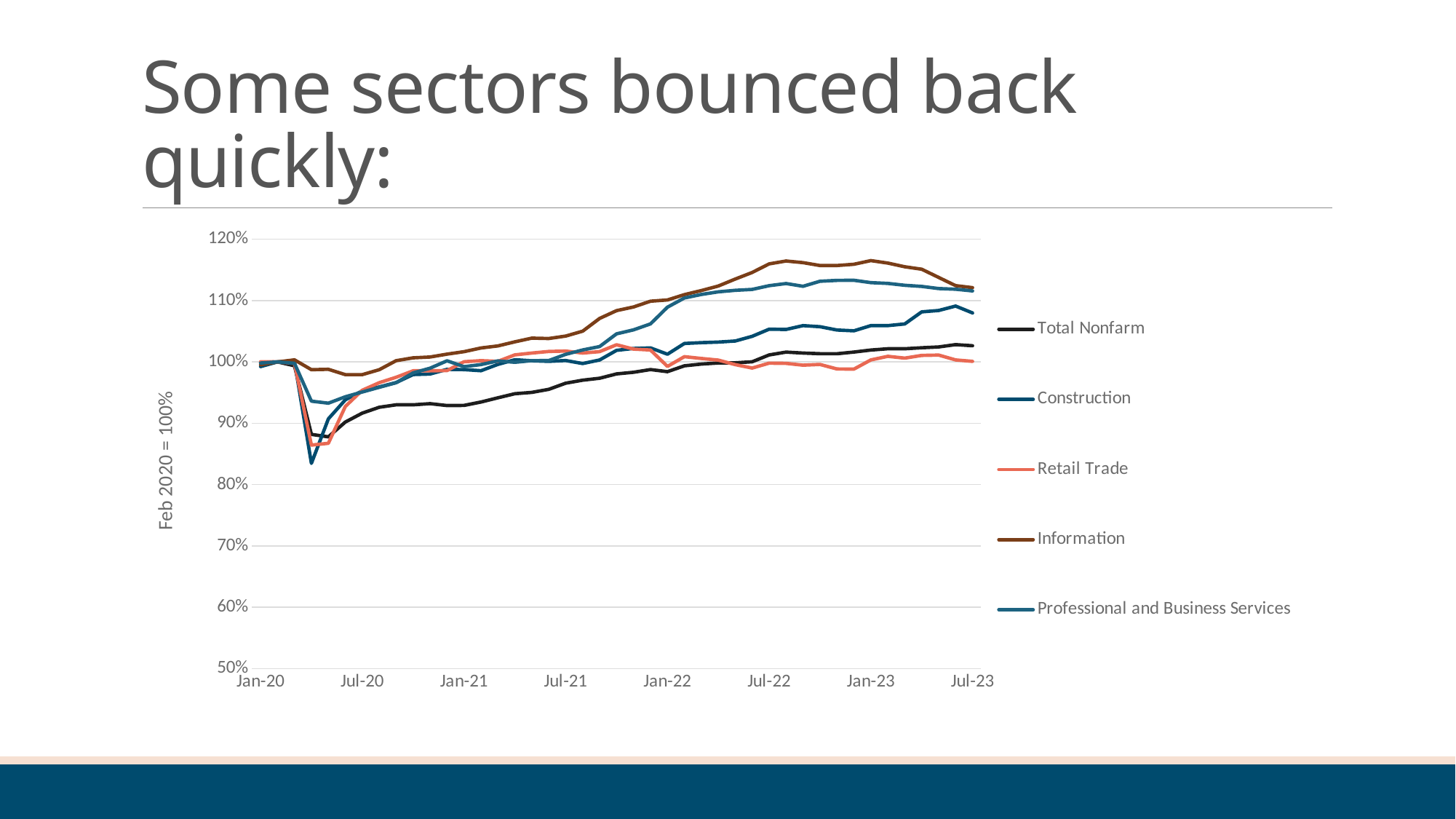
What is the title of the slide above the chart? Some sectors bounced back quickly: What kind of chart is shown on the slide? line chart Is the value for Construction at Jul-23 greater or less than 100%? greater What is the label on the vertical axis of the chart? Feb 2020 = 100% Which series dropped to the lowest point during 2020? Construction Which series is highest at Jul-22? Information How many series does the legend list? 5 At Jan-23, which is larger: Information or Retail Trade? Information Is the value for Total Nonfarm at Jul-20 greater or less than 100%? less Which series is lowest at Jul-23? Retail Trade Does the Total Nonfarm series rise or fall from Jan-21 to Jul-23? rise Is the value for Information at Jul-22 greater or less than 110%? greater